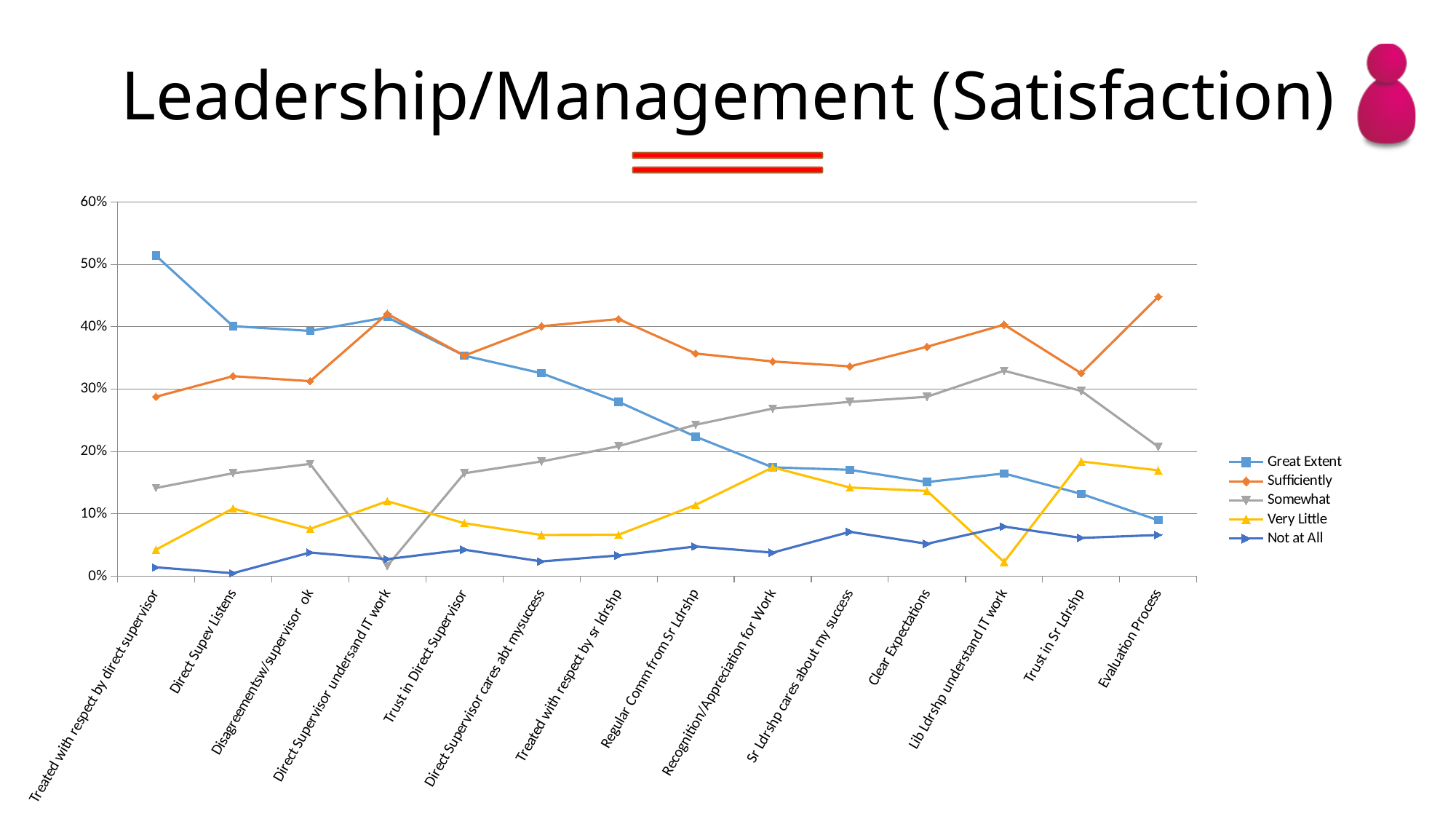
For which category is the Great Extent series highest? Treated with respect by direct supervisor For which category is the Somewhat series lowest? Direct Supervisor undersand IT work Is the Somewhat value for Lib Ldrshp understand IT work greater or less than 30%? greater What kind of chart is shown on the slide? line chart What colour is the Sufficiently series in the legend? orange Is the Great Extent value for Treated with respect by direct supervisor greater or less than 40%? greater For Evaluation Process, which is larger: Sufficiently or Great Extent? Sufficiently How many categories are plotted along the x axis? 14 Is the Not at All value for Direct Supev Listens greater or less than 10%? less Does the Great Extent series rise or fall from Trust in Direct Supervisor to Recognition/Appreciation for Work? fall For which category is the Sufficiently series highest? Evaluation Process How many series does the legend list? 5